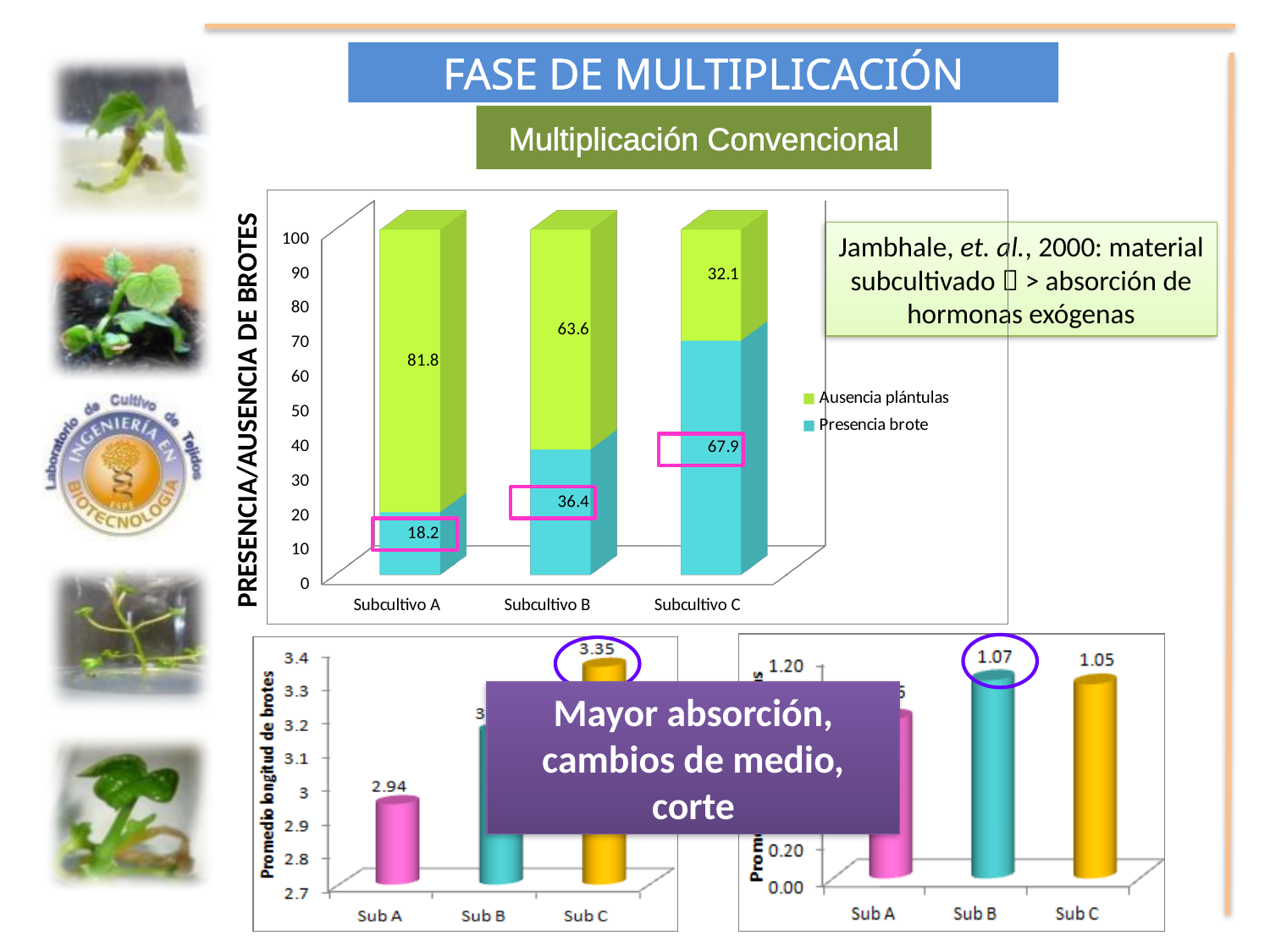
In the top stacked bar chart, what is the value of Ausencia plántulas for Subcultivo B? 63.6 In the bottom-left chart (Promedio longitud de brotes), what is the value for Sub A? 2.94 In the bottom-left chart (Promedio longitud de brotes), what is the value for Sub C? 3.35 How many series does the legend of the top stacked bar chart list? 2 In the top stacked bar chart, what is the total of the stacked bar for Subcultivo C? 100 In the top stacked bar chart, what is the value of Presencia brote for Subcultivo A? 18.2 In the bottom-right chart, which is larger, the value for Sub B or the value for Sub C? Sub B In the top stacked bar chart, which subcultivo has the lowest Ausencia plántulas value? Subcultivo C How many categories are shown on the x axis of the top stacked bar chart? 3 In the top stacked bar chart, which subcultivo has the highest Presencia brote value? Subcultivo C In the top stacked bar chart, what is the value of Presencia brote for Subcultivo C? 67.9 In the top stacked bar chart, what is the difference between the Presencia brote values for Subcultivo B and Subcultivo A? 18.2